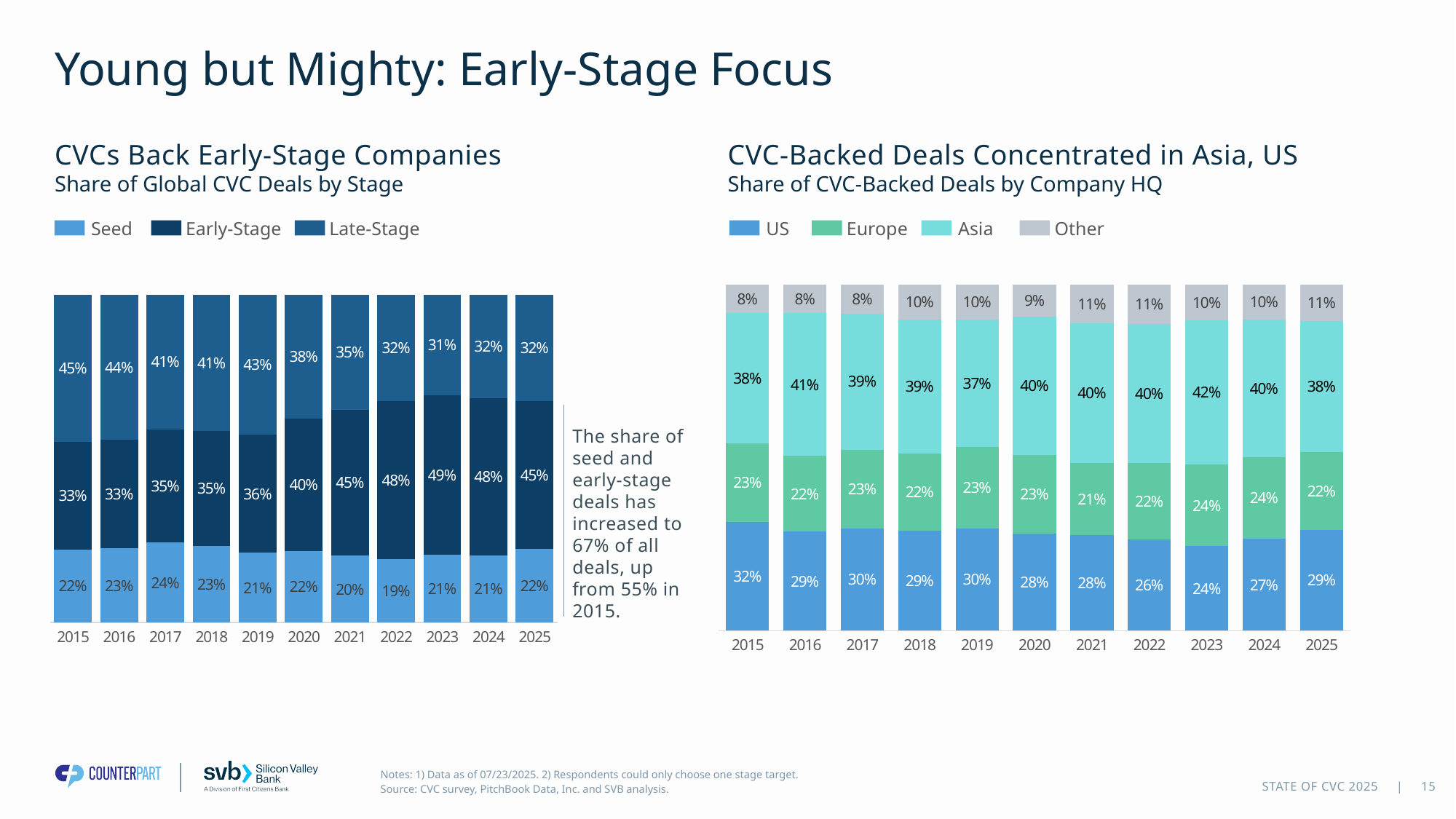
What type of chart is the 'CVC-Backed Deals Concentrated in Asia, US' chart? Stacked bar chart In the 'CVCs Back Early-Stage Companies' chart, how much did the Late-Stage share fall from 2015 to 2025? 13 percentage points How many years are shown on the x axis of the 'CVC-Backed Deals Concentrated in Asia, US' chart? 11 In the 'CVCs Back Early-Stage Companies' chart, what is the Late-Stage share in 2015? 45% In the 'CVC-Backed Deals Concentrated in Asia, US' chart, which is larger in 2025: the US share or the Europe share? US In the 'CVC-Backed Deals Concentrated in Asia, US' chart, what is the Asia share in 2023? 42% In the 'CVCs Back Early-Stage Companies' chart, which year has the lowest Seed share? 2022 How many series does the legend of the 'CVCs Back Early-Stage Companies' chart list? 3 In the 'CVC-Backed Deals Concentrated in Asia, US' chart, what is the US share in 2015? 32% In the 'CVCs Back Early-Stage Companies' chart, does the Early-Stage share generally rise or fall from 2015 to 2023? rise In the 'CVCs Back Early-Stage Companies' chart, what is the Early-Stage share in 2023? 49% In the 'CVC-Backed Deals Concentrated in Asia, US' chart, which year has the lowest US share? 2023